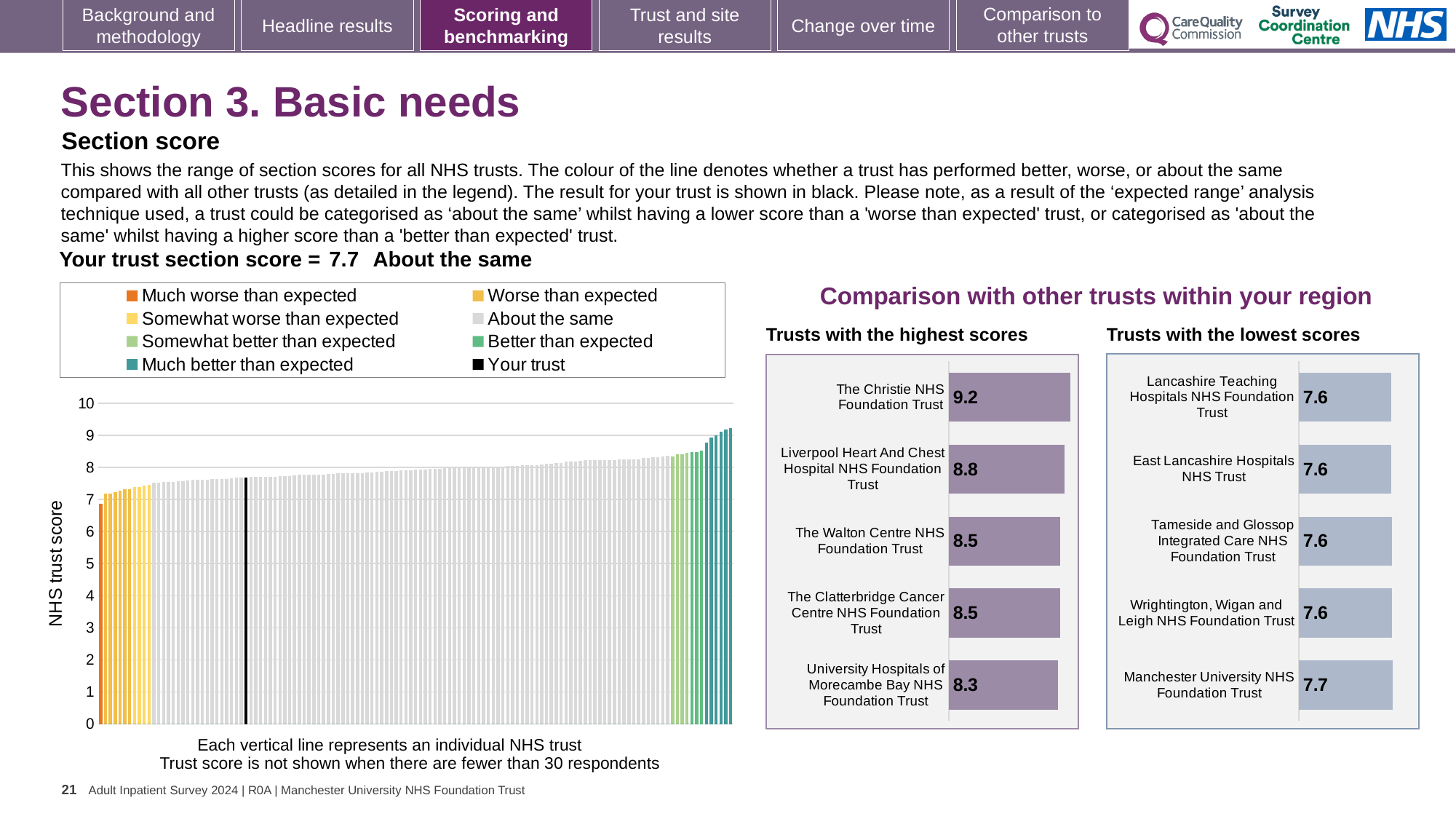
In the 'Trusts with the lowest scores' chart, what is the score for Manchester University NHS Foundation Trust? 7.7 In the 'Trusts with the highest scores' chart, what is the difference between the scores of The Christie NHS Foundation Trust and University Hospitals of Morecambe Bay NHS Foundation Trust? 0.9 In the 'Trusts with the highest scores' chart, which trust has the highest score? The Christie NHS Foundation Trust In the 'Trusts with the highest scores' chart, what is the score for The Christie NHS Foundation Trust? 9.2 In the main chart on the left showing all NHS trusts, is the value for 'Your trust' (the black bar) greater or less than 8? less In the 'Trusts with the lowest scores' chart, which trust has the highest score? Manchester University NHS Foundation Trust How many entries does the legend of the main chart on the left list? 8 In the 'Trusts with the highest scores' chart, what is the score for Liverpool Heart And Chest Hospital NHS Foundation Trust? 8.8 In the 'Trusts with the highest scores' chart, how many trusts are shown? 5 In the 'Trusts with the lowest scores' chart, what is the score for East Lancashire Hospitals NHS Trust? 7.6 In the 'Trusts with the highest scores' chart, which trust has the lowest score? University Hospitals of Morecambe Bay NHS Foundation Trust In the 'Trusts with the lowest scores' chart, is the score for Wrightington, Wigan and Leigh NHS Foundation Trust larger or smaller than the score for Manchester University NHS Foundation Trust? smaller